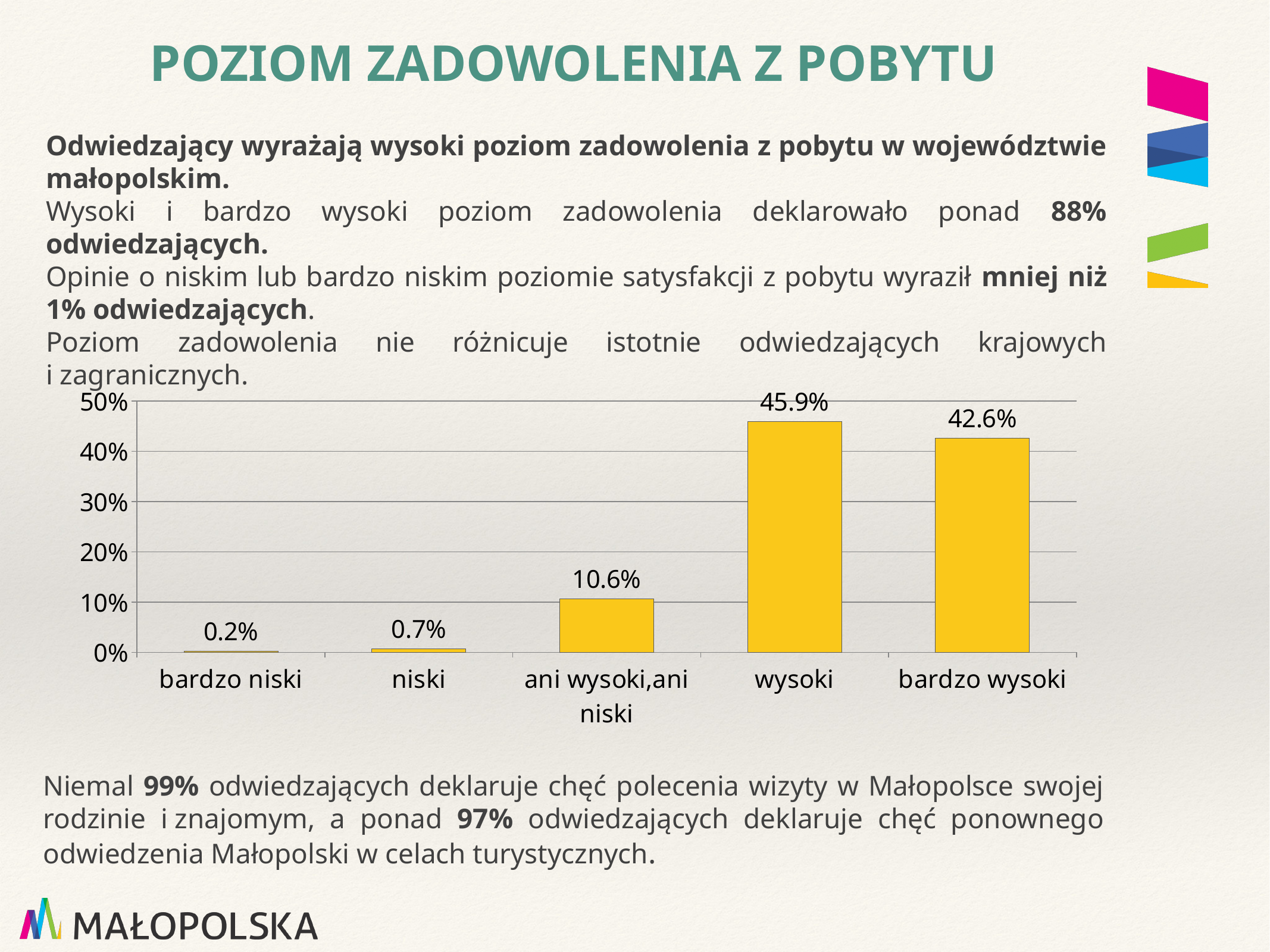
What is the value for "bardzo wysoki"? 42.6% How many categories are shown on the x axis of the chart? 5 Which category has the highest value? wysoki What is the value for "niski"? 0.7% Which category has the lowest value? bardzo niski What is the value for "wysoki"? 45.9% Is the value for "bardzo wysoki" greater or less than 40%? greater Which is larger, the value for "niski" or the value for "ani wysoki,ani niski"? ani wysoki,ani niski What kind of chart is shown on the slide? bar chart What is the value for "bardzo niski"? 0.2% What is the difference between the values for "wysoki" and "bardzo wysoki"? 3.3% What is the value for "ani wysoki,ani niski"? 10.6%